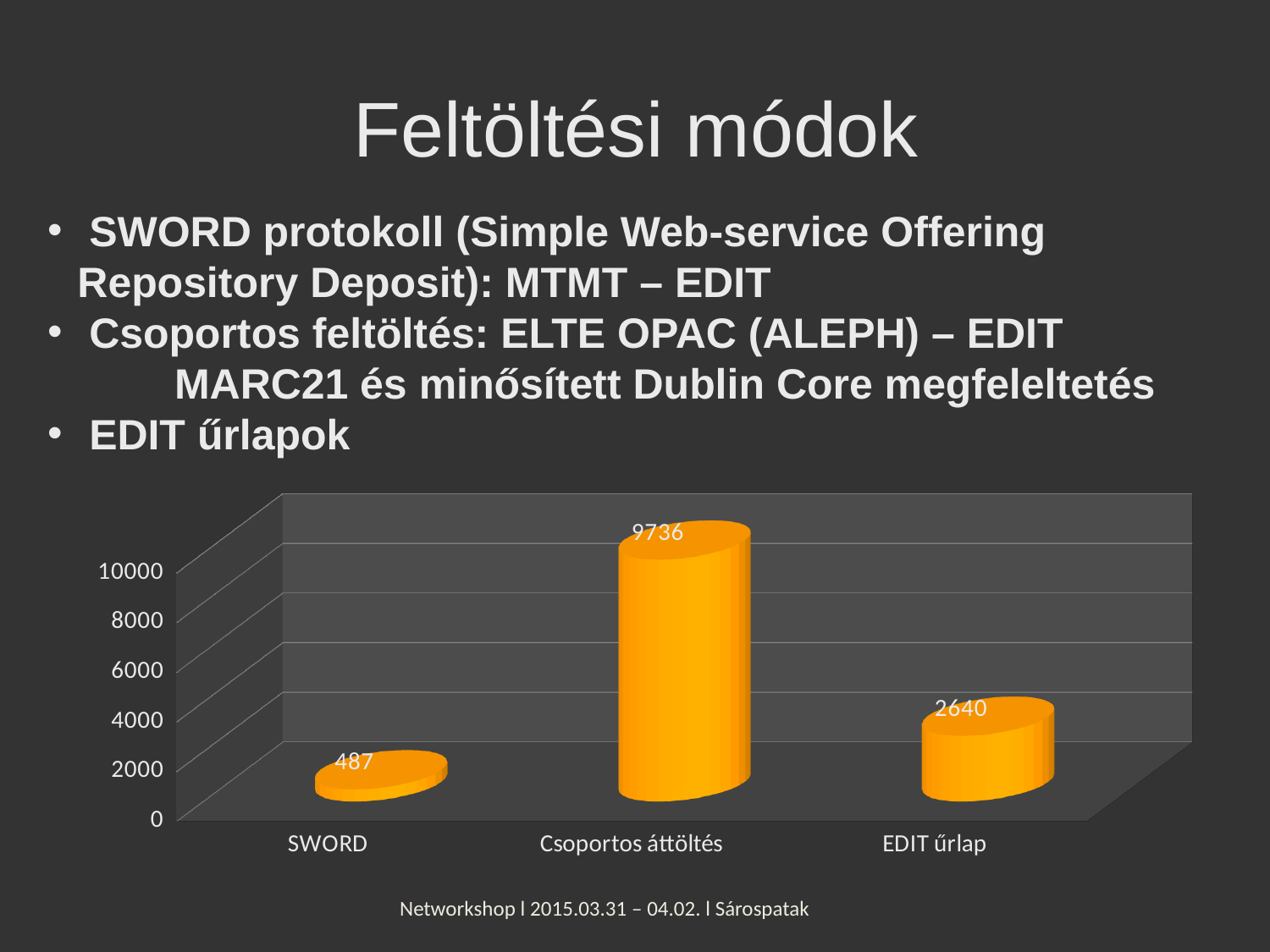
Is the value for Csoportos áttöltés greater or less than 8000? greater Which category has the highest value? Csoportos áttöltés Which category has the lowest value? SWORD What is the value for SWORD? 487 Which is larger, the value for EDIT űrlap or the value for SWORD? EDIT űrlap What is the difference between the values for EDIT űrlap and SWORD? 2153 What is the value for Csoportos áttöltés? 9736 What is the value for EDIT űrlap? 2640 What kind of chart is shown on the slide? bar chart How many categories are shown on the x axis of the chart? 3 What is the difference between the values for Csoportos áttöltés and EDIT űrlap? 7096 Is the value for EDIT űrlap greater or less than 4000? less